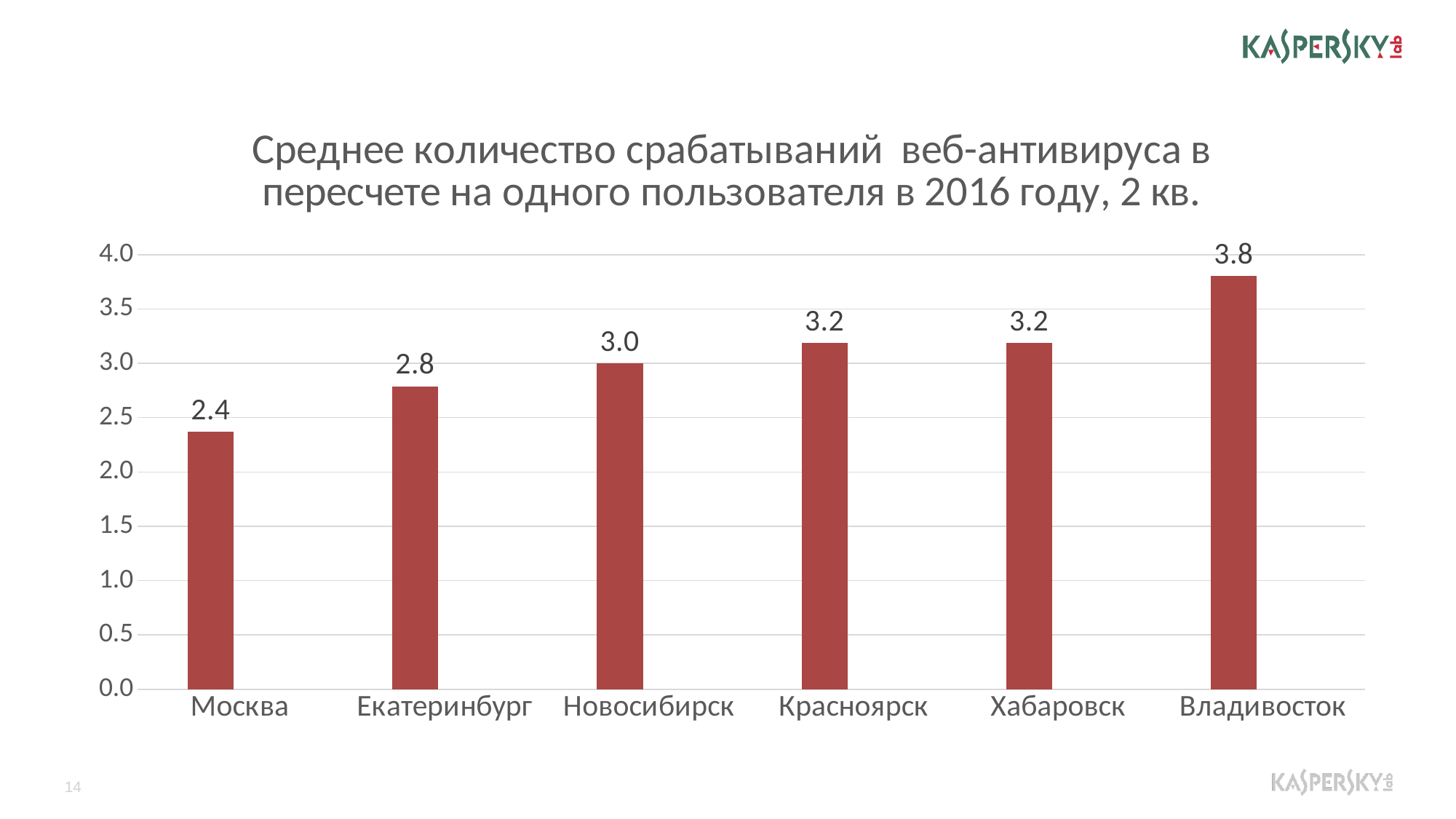
Do the values generally rise or fall from Москва to Владивосток? rise Which city has the lowest value? Москва Which city has the highest value? Владивосток Is the value for Москва greater or less than 2.5? less What is the difference between the values for Красноярск and Екатеринбург? 0.4 How many cities are shown on the chart? 6 What is the value for Москва? 2.4 What is the difference between the values for Владивосток and Москва? 1.4 What is the value for Владивосток? 3.8 Which is larger, the value for Екатеринбург or the value for Хабаровск? Хабаровск What kind of chart is shown on the slide? bar chart What is the value for Новосибирск? 3.0